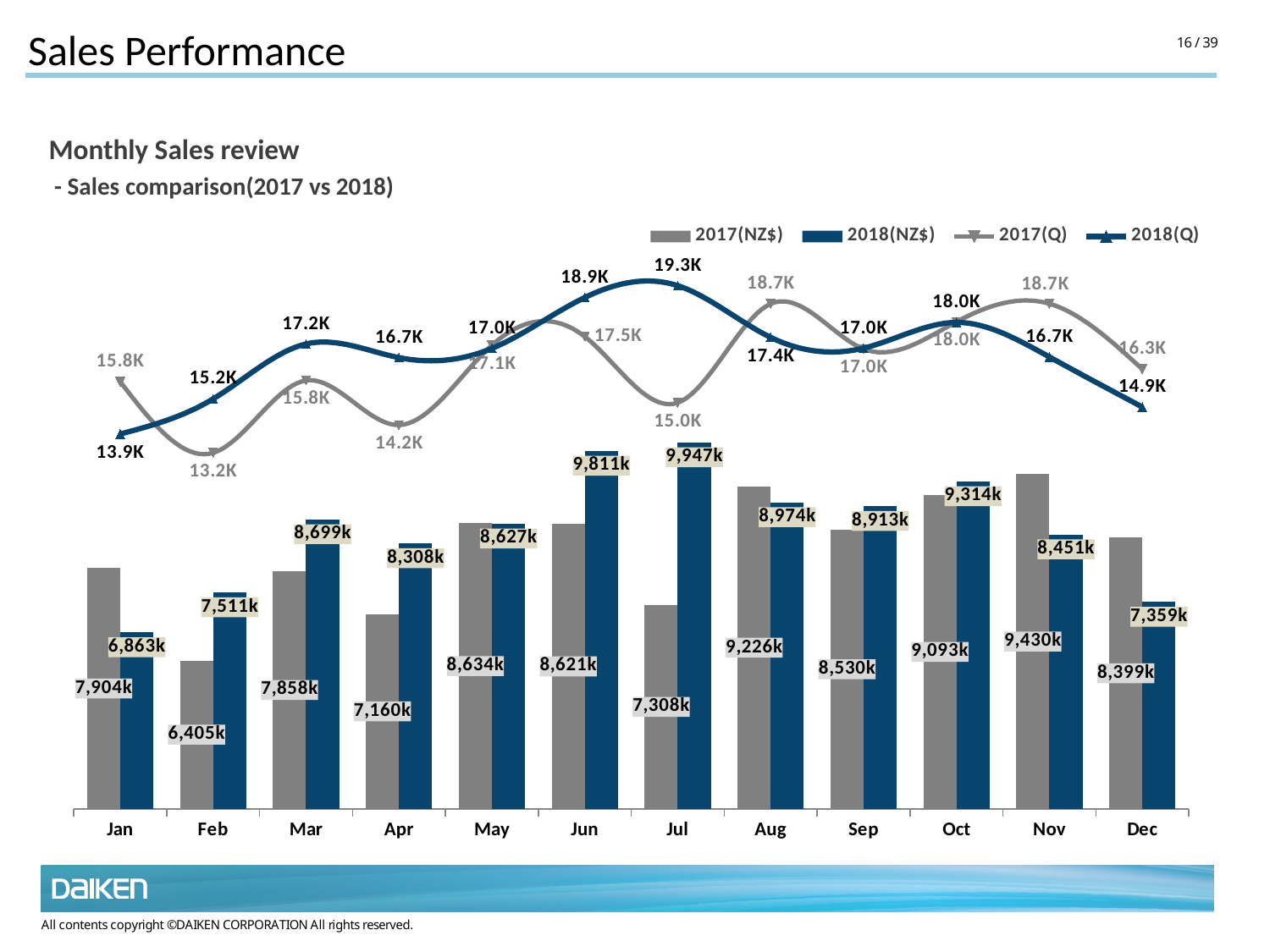
Which month has the highest 2017(NZ$) value? Nov What is the 2017(Q) value for Apr? 14.2K What kind of chart is this? Combined bar and line chart What is the 2018(Q) value for Jun? 18.9K Which month has the lowest 2018(NZ$) value? Jan How many months are shown on the x axis? 12 Which is larger for Nov, the 2017(NZ$) value or the 2018(NZ$) value? 2017(NZ$) How many series does the legend list? 4 What is the difference between the 2018(NZ$) and 2017(NZ$) values for Jul? 2,639k What is the 2018(NZ$) value for Jul? 9,947k Which series is shown with gray bars? 2017(NZ$) What is the 2017(NZ$) value for Feb? 6,405k